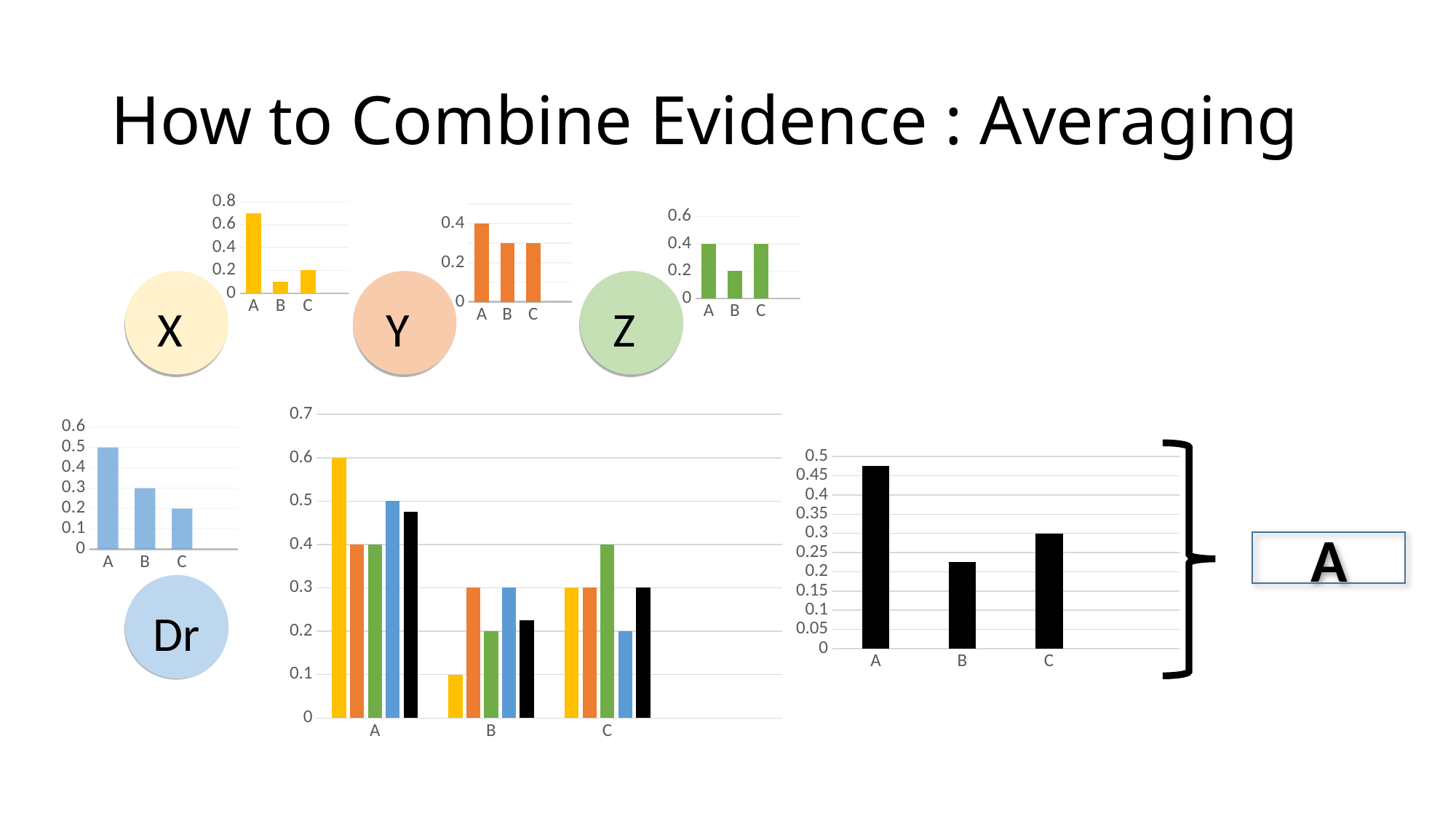
In the chart next to the X circle, which category has the highest value? A In the chart next to the Y circle, what is the value for category A? 0.4 In the large grouped bar chart in the centre, how many categories are on the x axis? 3 In the large grouped bar chart in the centre, how many bars are shown for each category? 5 In the chart next to the Z circle, which category has the lowest value? B In the chart next to the Dr circle, what is the value for category A? 0.5 In the black bar chart on the right, what is the value for category C? 0.3 In the large grouped bar chart in the centre, what is the value of the yellow bar for category A? 0.6 In the black bar chart on the right, is the value for A greater or less than 0.4? greater In the chart next to the Dr circle, do the values rise or fall from A to C? fall What type of chart is the black chart on the right? bar chart